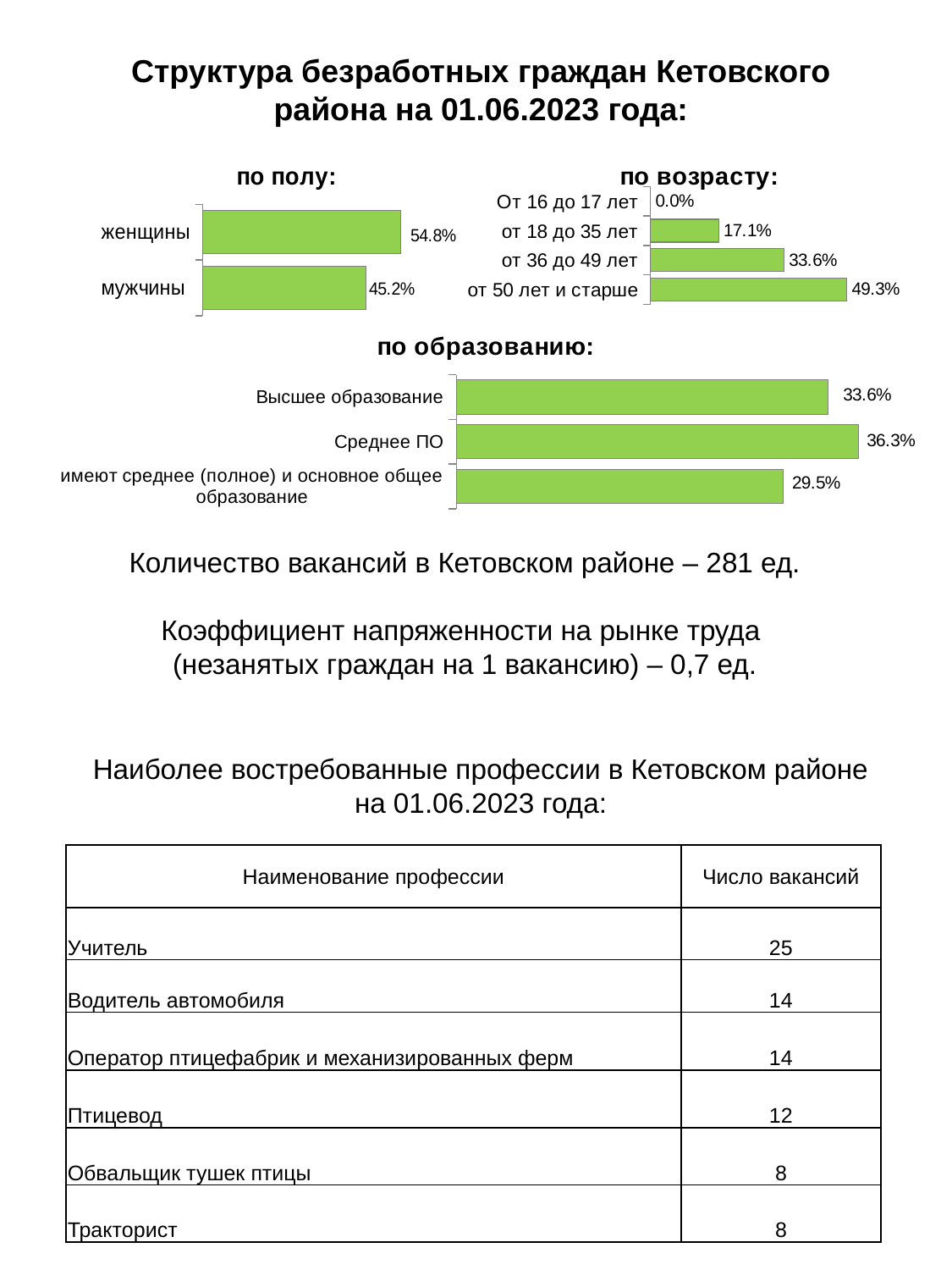
In the chart titled "по полу:", what is the difference between the values for женщины and мужчины? 9.6% In the chart titled "по образованию:", which category has the lowest value? имеют среднее (полное) и основное общее образование In the chart titled "по полу:", what is the value for женщины? 54.8% In the chart titled "по возрасту:", what is the value for от 18 до 35 лет? 17.1% In the chart titled "по возрасту:", which age category has the lowest value? От 16 до 17 лет In the chart titled "по полу:", what is the value for мужчины? 45.2% In the chart titled "по возрасту:", which age category has the highest value? от 50 лет и старше In the chart titled "по возрасту:", what is the difference between the values for от 50 лет и старше and от 36 до 49 лет? 15.7% In the chart titled "по образованию:", what is the value for Среднее ПО? 36.3% In the chart titled "по возрасту:", how many age categories are shown? 4 In the chart titled "по образованию:", which is larger: the value for Высшее образование or for Среднее ПО? Среднее ПО What type of chart is the chart titled "по образованию:"? bar chart